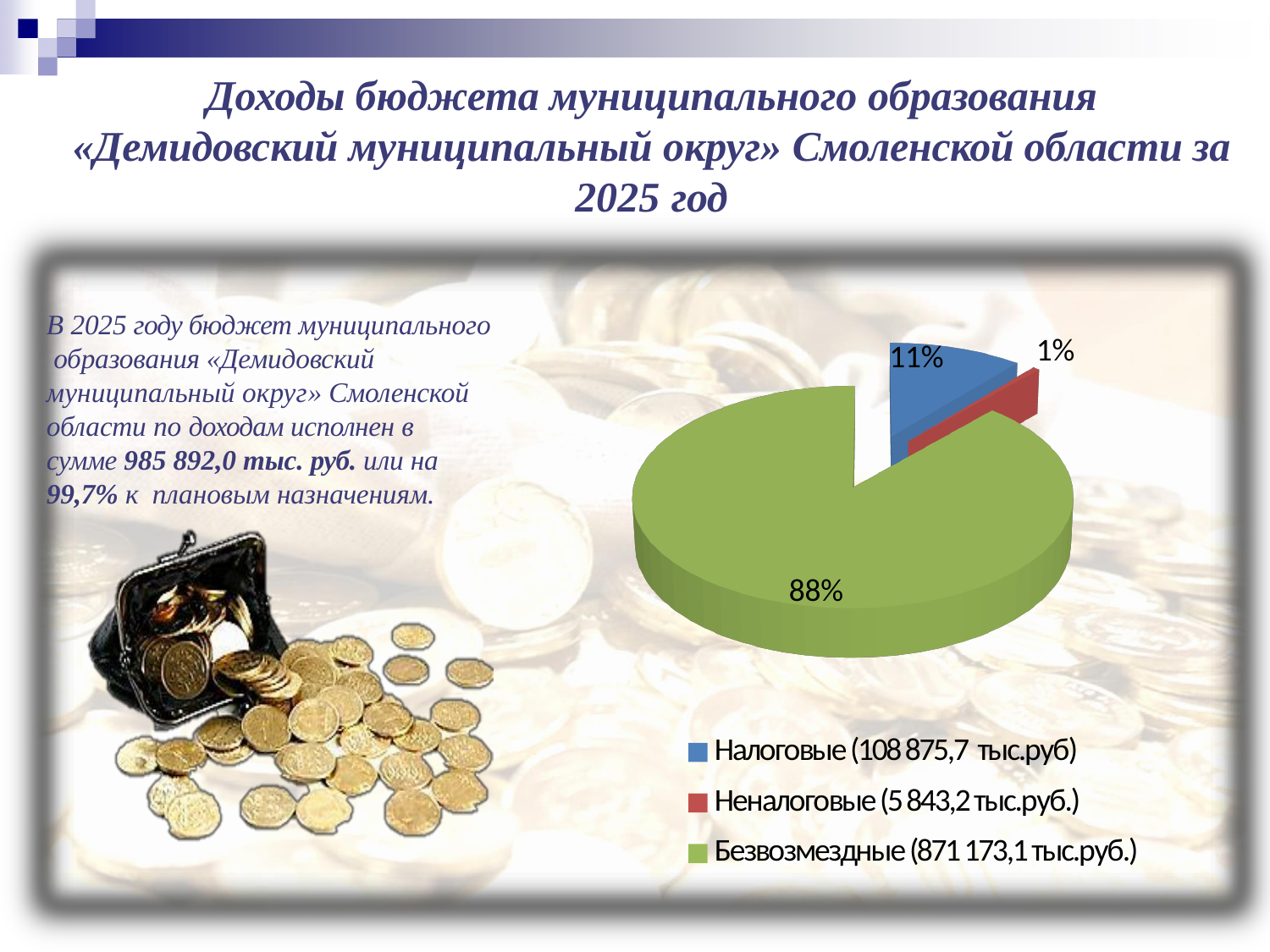
What amount in тыс.руб. is given in the legend for Безвозмездные? 871 173,1 тыс.руб. Which category has the largest slice of the pie? Безвозмездные What amount in тыс.руб. is given in the legend for Налоговые? 108 875,7 тыс.руб What type of chart is shown on the slide? pie chart What share of the pie does the Безвозмездные slice represent? 88% By how many percentage points does the Безвозмездные share exceed the Налоговые share? 77 percentage points What share of the pie does the Налоговые slice represent? 11% How many entries does the legend list? 3 Which category has the smallest slice of the pie? Неналоговые What share of the pie does the Неналоговые slice represent? 1% Which is larger, the Налоговые slice or the Неналоговые slice? Налоговые How many slices does the pie chart have? 3